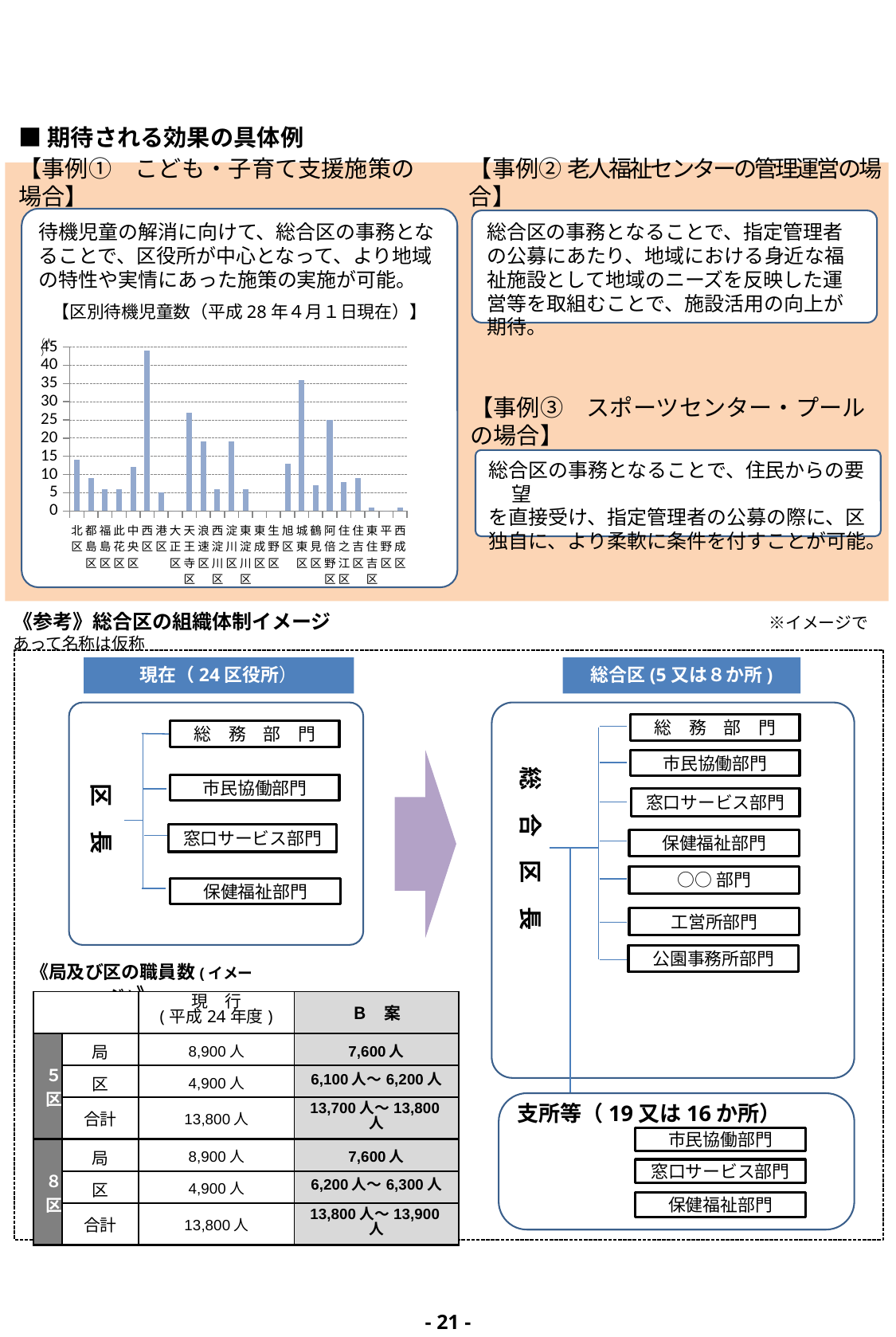
Is the value for 城東区 greater or less than 30? greater What is the highest tick value shown on the y axis of the chart? 45 Is the value for 西区 greater or less than 40? greater What kind of chart is shown on the slide? bar chart Which has a larger value, 西区 or 城東区? 西区 Which ward has the highest number of waiting children in the chart? 西区 What is the title of the chart? 区別待機児童数（平成28年4月1日現在） Is the value for 阿倍野区 greater or less than 20? greater Which has a larger value, 北区 or 都島区? 北区 How many wards (categories) are plotted on the x axis of the chart? 24